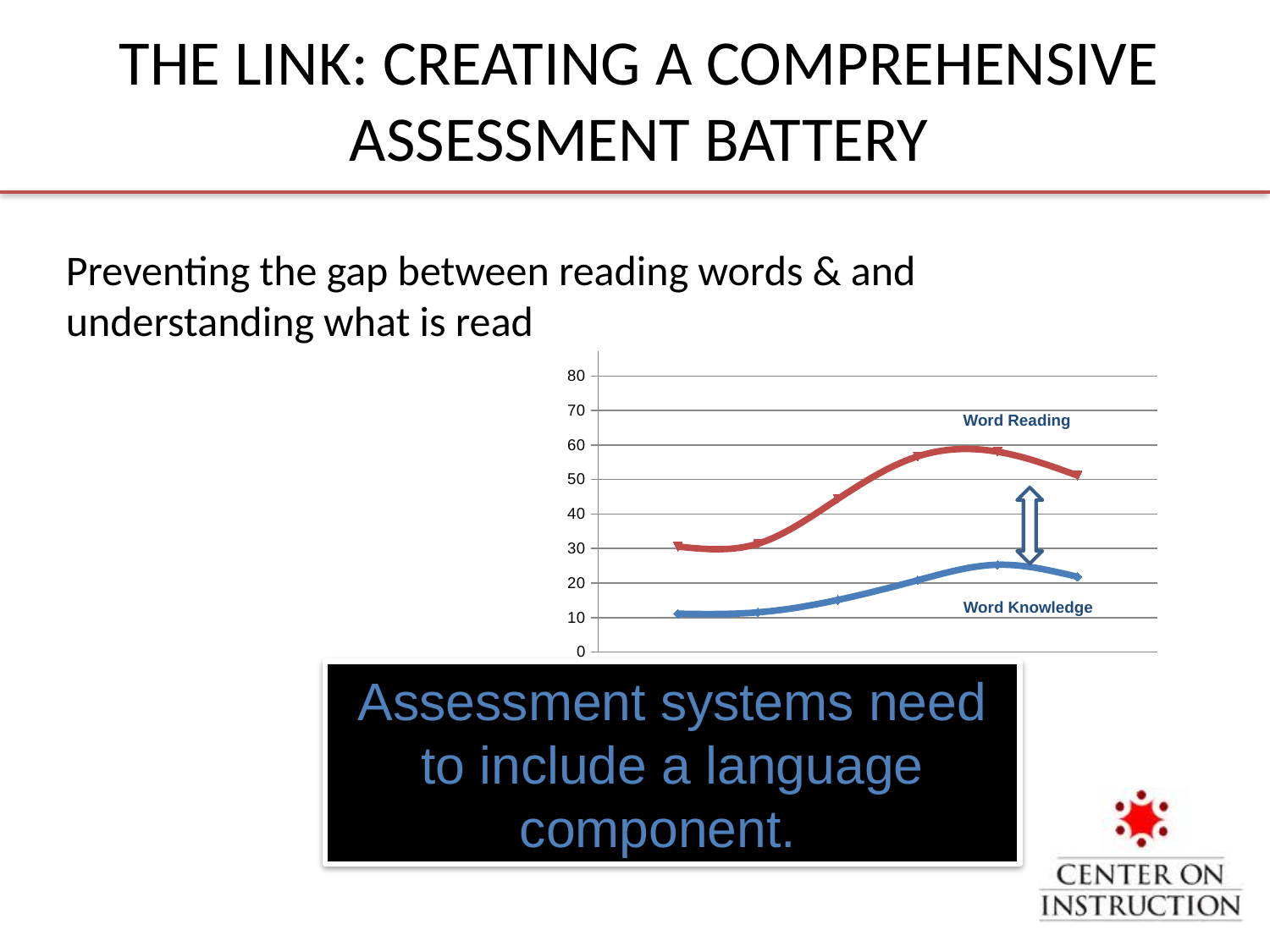
Which series has higher values throughout the chart, Word Reading or Word Knowledge? Word Reading Does the Word Knowledge line rise or fall from its first point to its fourth point? rise What is the highest value shown on the vertical axis? 80 Is the first value of the Word Reading line greater or less than 20? greater How many data points does the Word Reading line have? 6 Is the highest value of the Word Reading line greater or less than 50? greater Is the highest value of the Word Knowledge line greater or less than 30? less Which series has the lowest values on the chart? Word Knowledge What kind of chart is shown on the slide? line chart How many series are plotted on the chart? 2 What colour is the Word Reading line? red